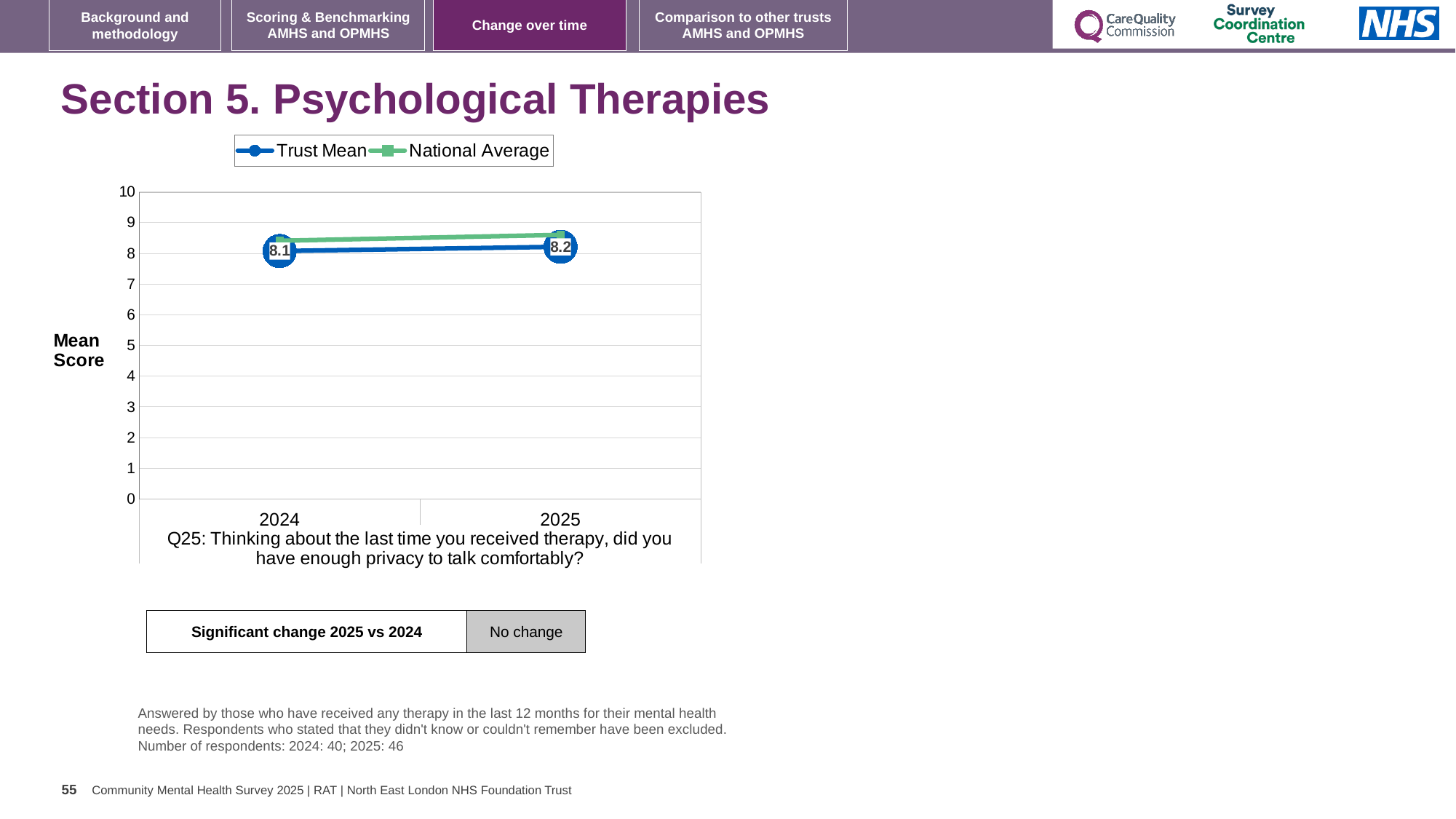
Is the National Average value for 2024 greater or less than 8? greater What is the Trust Mean value for 2025? 8.2 Does the Trust Mean rise or fall from 2024 to 2025? rise What is the label on the y axis of the chart? Mean Score What kind of chart is shown on the slide? line chart What is the Trust Mean value for 2024? 8.1 How many series does the legend list? 2 By how much did the Trust Mean change from 2024 to 2025? 0.1 How many years are shown on the x axis of the chart? 2 In 2025, which series has the higher value, Trust Mean or National Average? National Average Is the National Average value for 2025 greater or less than 9? less Which series is shown in green in the legend? National Average